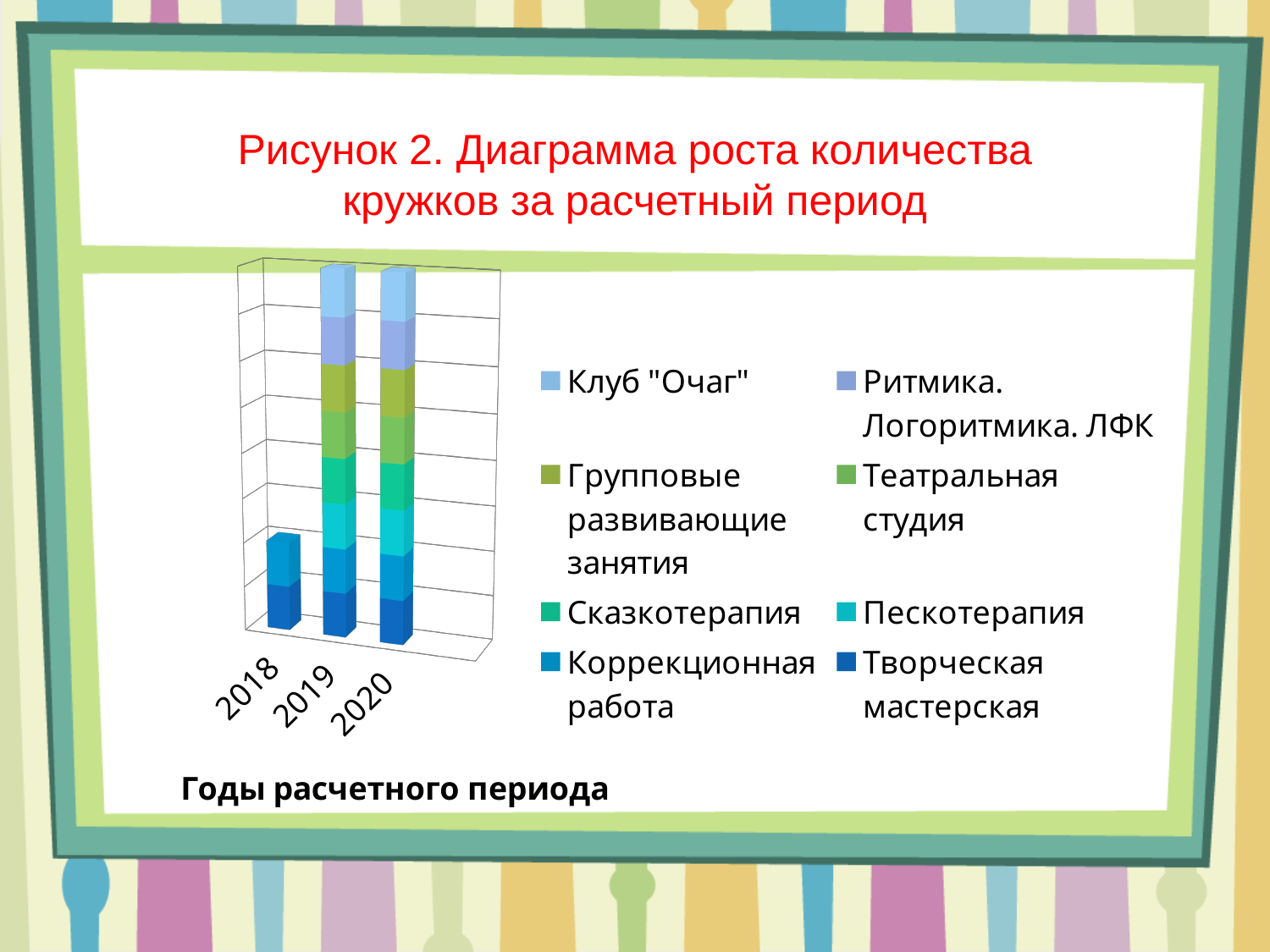
What is the title of the chart on the slide? Рисунок 2. Диаграмма роста количества кружков за расчетный период Which bar is taller, 2018 or 2019? 2019 What kind of chart is shown on the slide? Stacked bar chart How many series does the chart legend list? 8 Which year has the lowest total bar in the chart? 2018 How many years (categories) are shown on the x axis of the chart? 3 Does the total bar height rise or fall from 2018 to 2019? Rise What is the label of the x axis of the chart? Годы расчетного периода Which years are shown on the x axis of the chart? 2018, 2019, 2020 Which bar is taller, 2018 or 2020? 2020